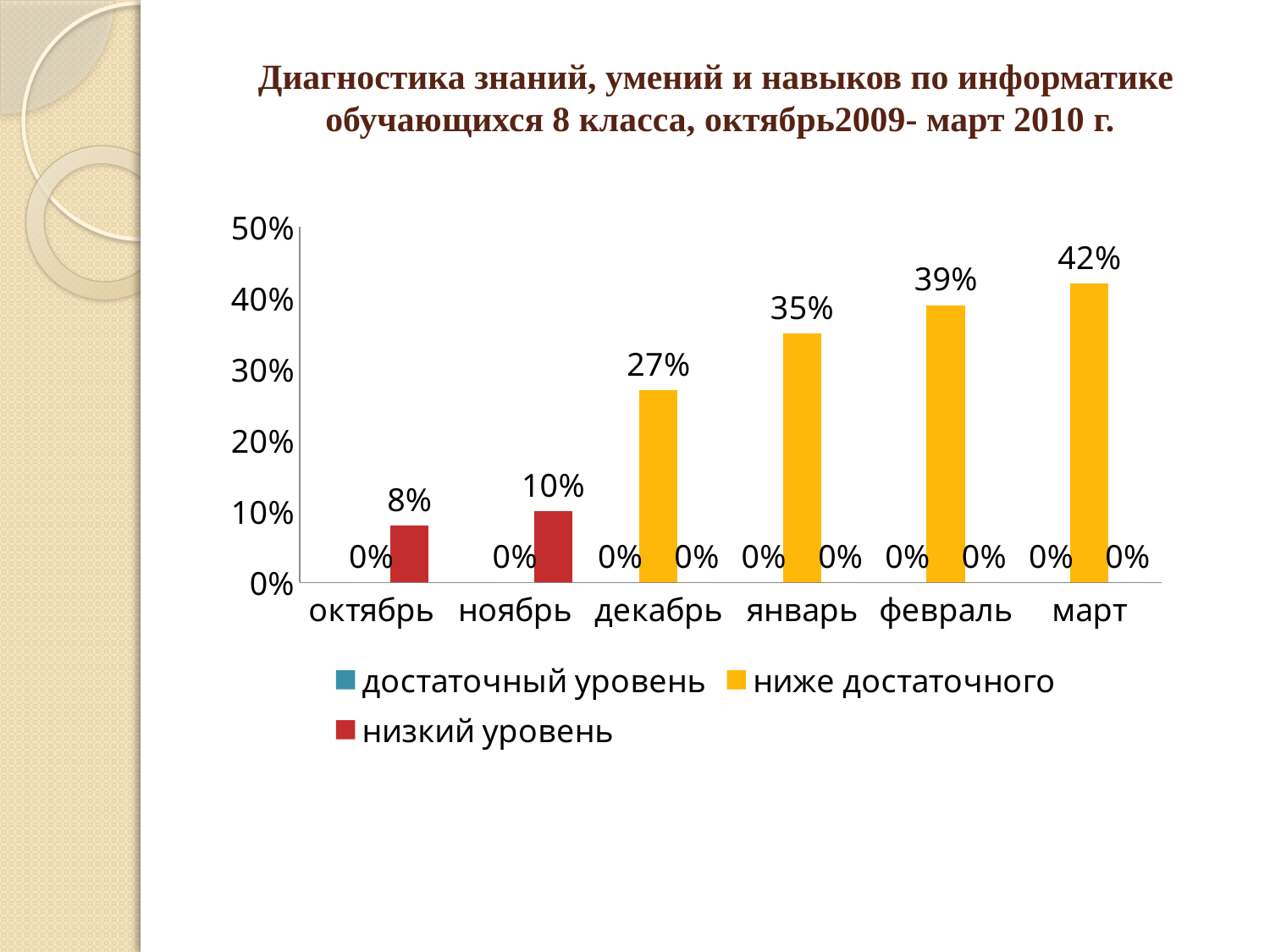
In which month is the value for ниже достаточного highest? март What is the value for низкий уровень in октябрь? 8% How many series does the legend list? 3 What is the value for ниже достаточного in март? 42% Which is larger, the ниже достаточного value for январь or for декабрь? январь Does the value for ниже достаточного rise or fall from декабрь to март? rise How many months are shown on the x axis? 6 What is the difference between the ниже достаточного values for март and февраль? 3% What is the value for ниже достаточного in февраль? 39% What is the difference between the низкий уровень values for ноябрь and октябрь? 2% What is the value for низкий уровень in ноябрь? 10% What is the value for ниже достаточного in январь? 35%